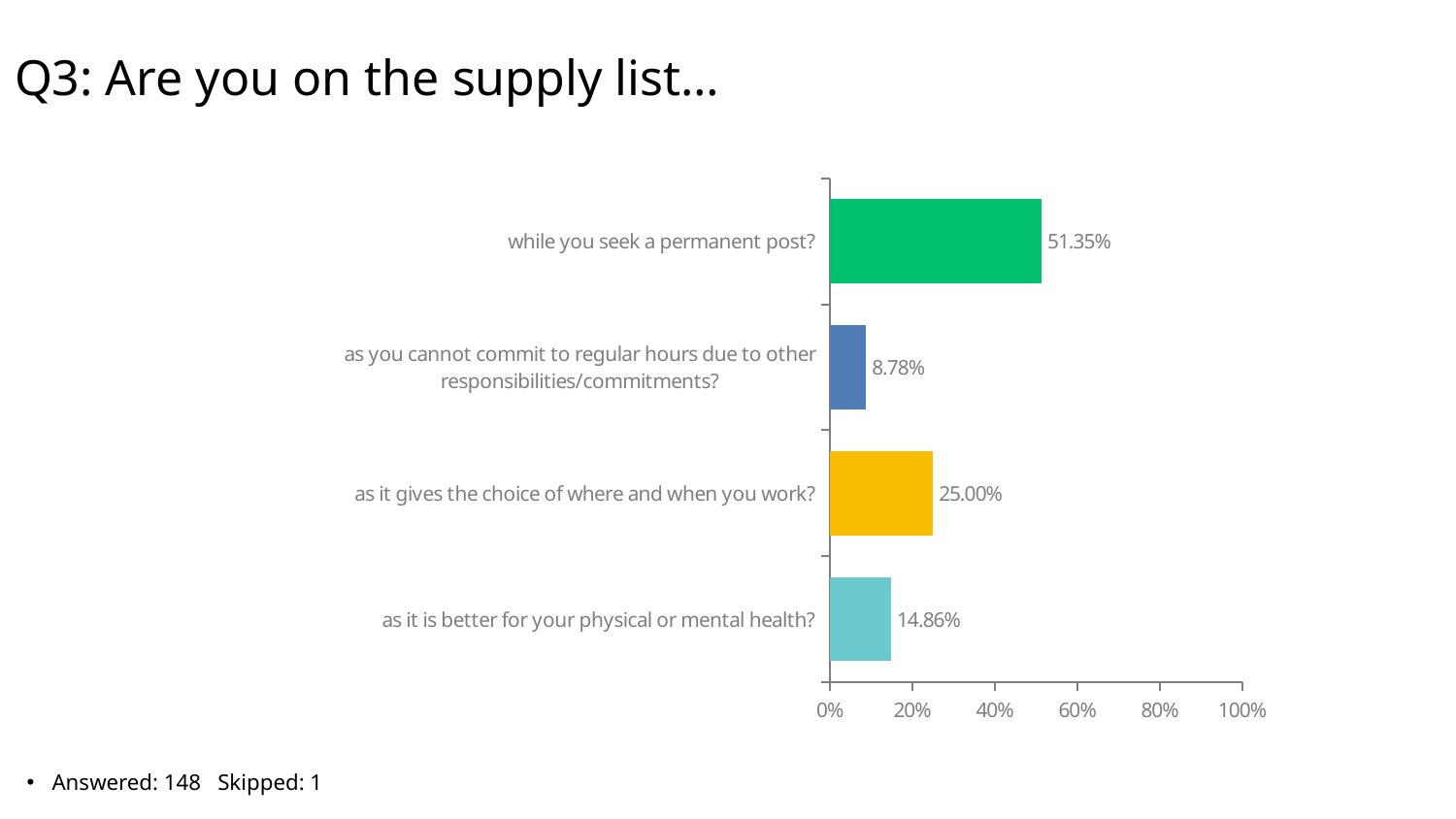
What percentage of respondents are on the supply list as it is better for their physical or mental health? 14.86% Which reason for being on the supply list has the highest percentage? while you seek a permanent post? Which has a larger percentage: 'as it gives the choice of where and when you work?' or 'as it is better for your physical or mental health?'? as it gives the choice of where and when you work? Is the value for 'while you seek a permanent post?' greater or less than 40%? greater What percentage of respondents are on the supply list as it gives the choice of where and when they work? 25.00% What is the difference in percentage points between 'while you seek a permanent post?' and 'as it gives the choice of where and when you work?'? 26.35 How many response categories are shown in the chart? 4 Which reason for being on the supply list has the lowest percentage? as you cannot commit to regular hours due to other responsibilities/commitments? What percentage of respondents are on the supply list as they cannot commit to regular hours due to other responsibilities/commitments? 8.78% What percentage of respondents are on the supply list while they seek a permanent post? 51.35% What is the title of the slide? Q3: Are you on the supply list... What type of chart is shown on the slide? bar chart